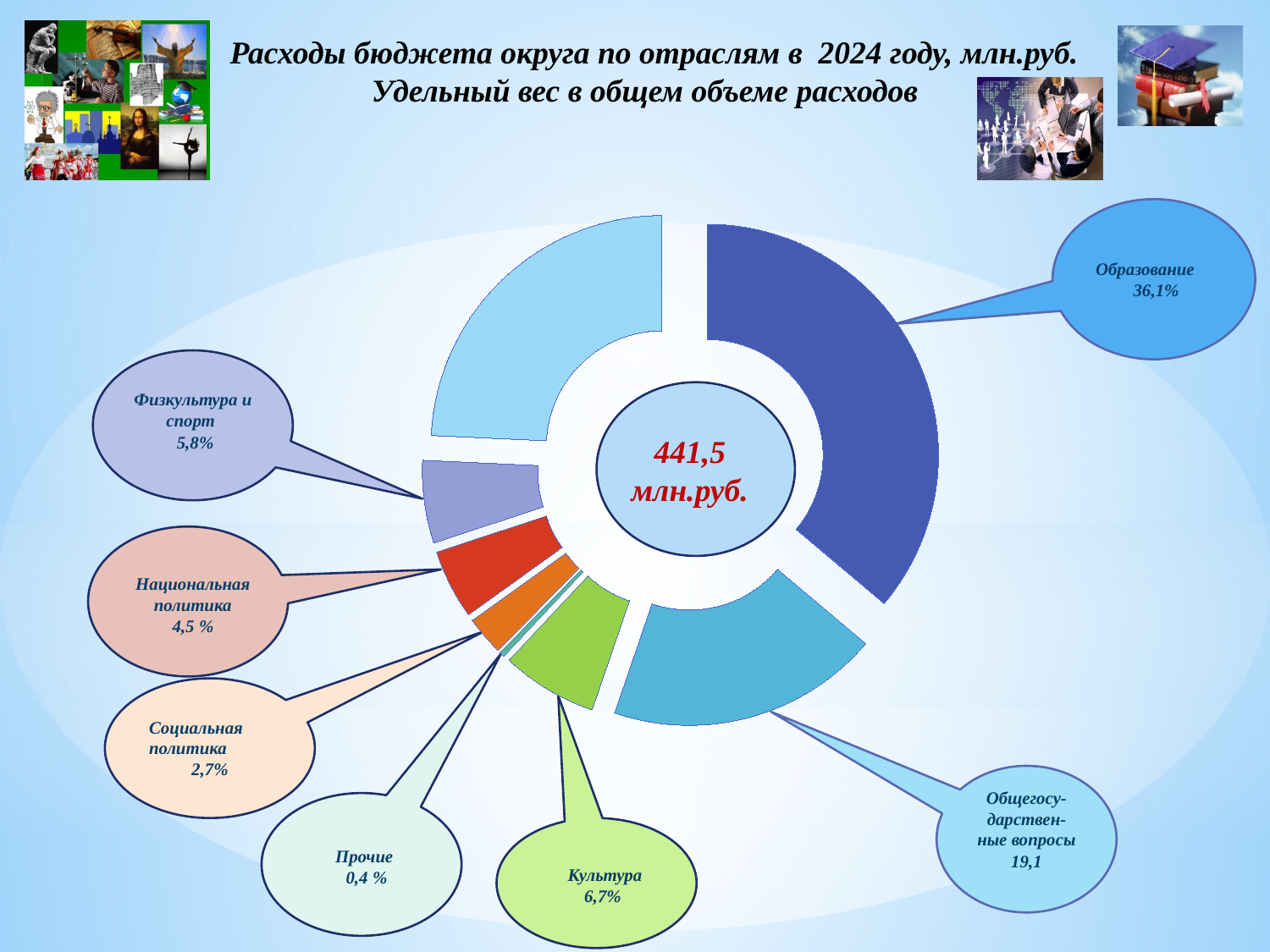
What is the share for Общегосударственные вопросы? 19,1 Which labelled sector has the largest share? Образование How many sectors are labelled with a name and share on the chart? 7 What share is shown for Культура? 6,7% Which is larger, the share for Национальная политика or for Социальная политика? Национальная политика What total amount is printed in the centre of the chart? 441,5 млн.руб. By how many percentage points does Образование exceed Общегосударственные вопросы? 17,0 What share of the budget expenditure goes to Образование? 36,1% What share is shown for Социальная политика? 2,7% What kind of chart is shown on the slide? Pie (doughnut) chart What share is shown for Физкультура и спорт? 5,8% Which labelled sector has the smallest share? Прочие